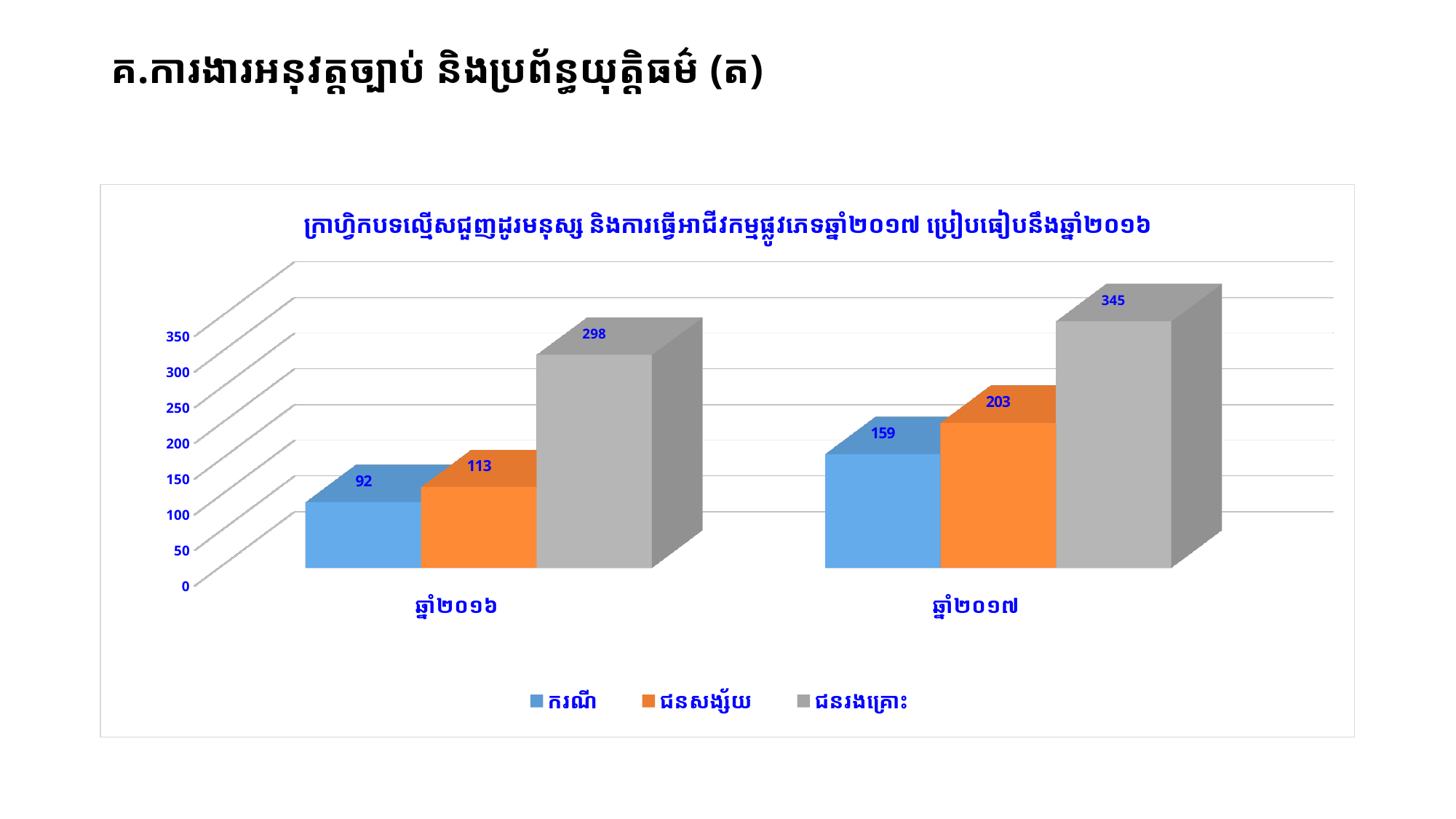
Which is larger: ជនសង្ស័យ in ឆ្នាំ២០១៦ or ជនសង្ស័យ in ឆ្នាំ២០១៧? ជនសង្ស័យ in ឆ្នាំ២០១៧ What is the value for ករណី in ឆ្នាំ២០១៦? 92 What is the difference between the ជនរងគ្រោះ values for ឆ្នាំ២០១៧ and ឆ្នាំ២០១៦? 47 Which series has the lowest value in ឆ្នាំ២០១៦? ករណី What kind of chart is shown on the slide? Bar chart How many categories are shown on the x axis? 2 Do the values for ករណី rise or fall from ឆ្នាំ២០១៦ to ឆ្នាំ២០១៧? Rise What is the difference between the ករណី values for ឆ្នាំ២០១៧ and ឆ្នាំ២០១៦? 67 What is the value for ជនរងគ្រោះ in ឆ្នាំ២០១៦? 298 How many series does the legend list? 3 Which series has the highest value in ឆ្នាំ២០១៧? ជនរងគ្រោះ What is the value for ជនសង្ស័យ in ឆ្នាំ២០១៧? 203